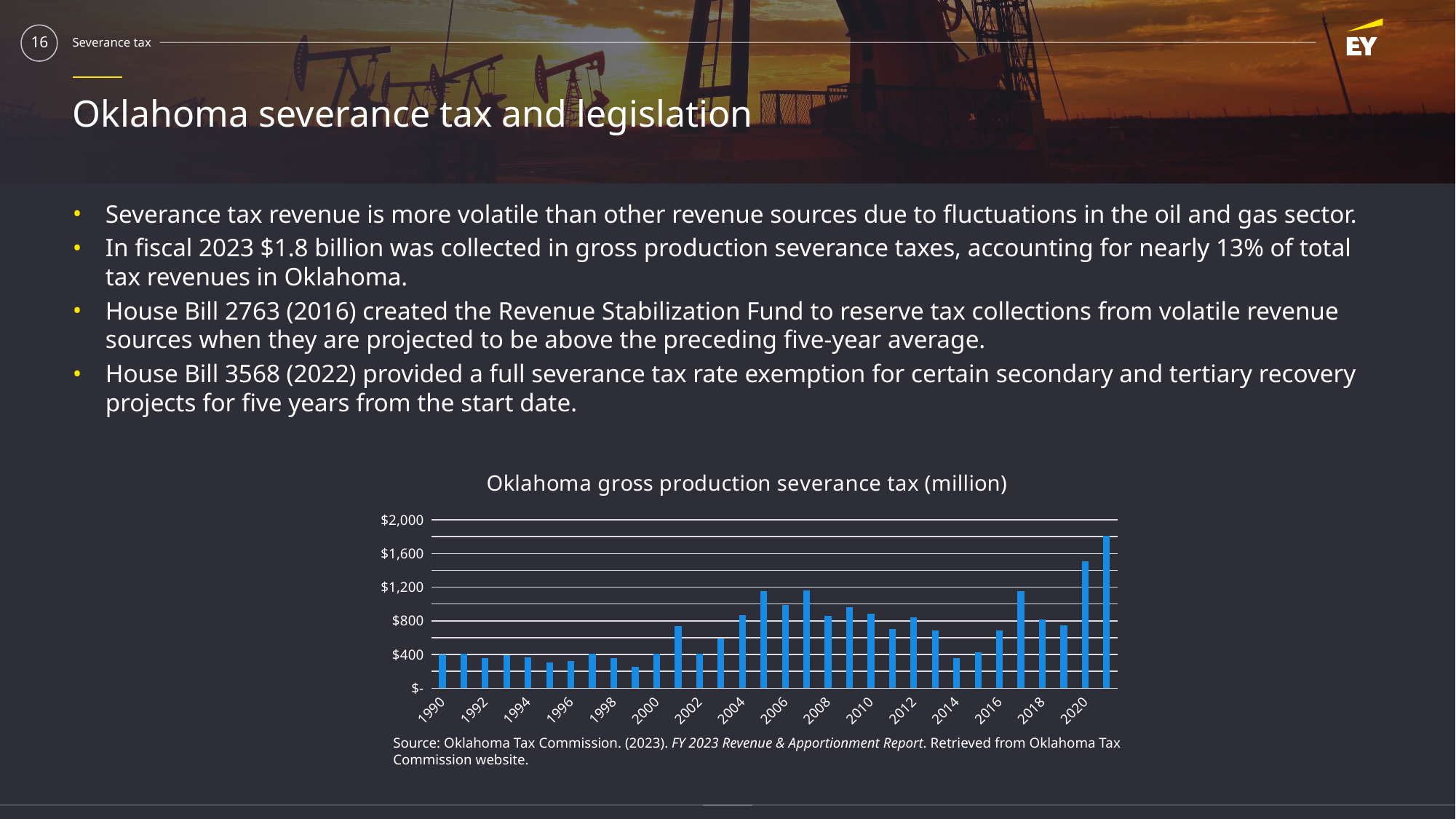
Which year has the highest gross production severance tax in the chart? 2021 Is the value for 2005 greater or less than $800? greater What kind of chart is shown on the slide? Bar chart Which year has the larger value, 2010 or 2020? 2020 Is the value for 2020 greater or less than $1,200? greater Is the value for 1999 greater or less than $400? less Which year has the lowest gross production severance tax in the chart? 1999 Do the values rise or fall from 2012 to 2014? fall What is the title of the chart? Oklahoma gross production severance tax (million) Which year has the larger value, 2001 or 2002? 2001 Do the values rise or fall from 2019 to 2021? rise